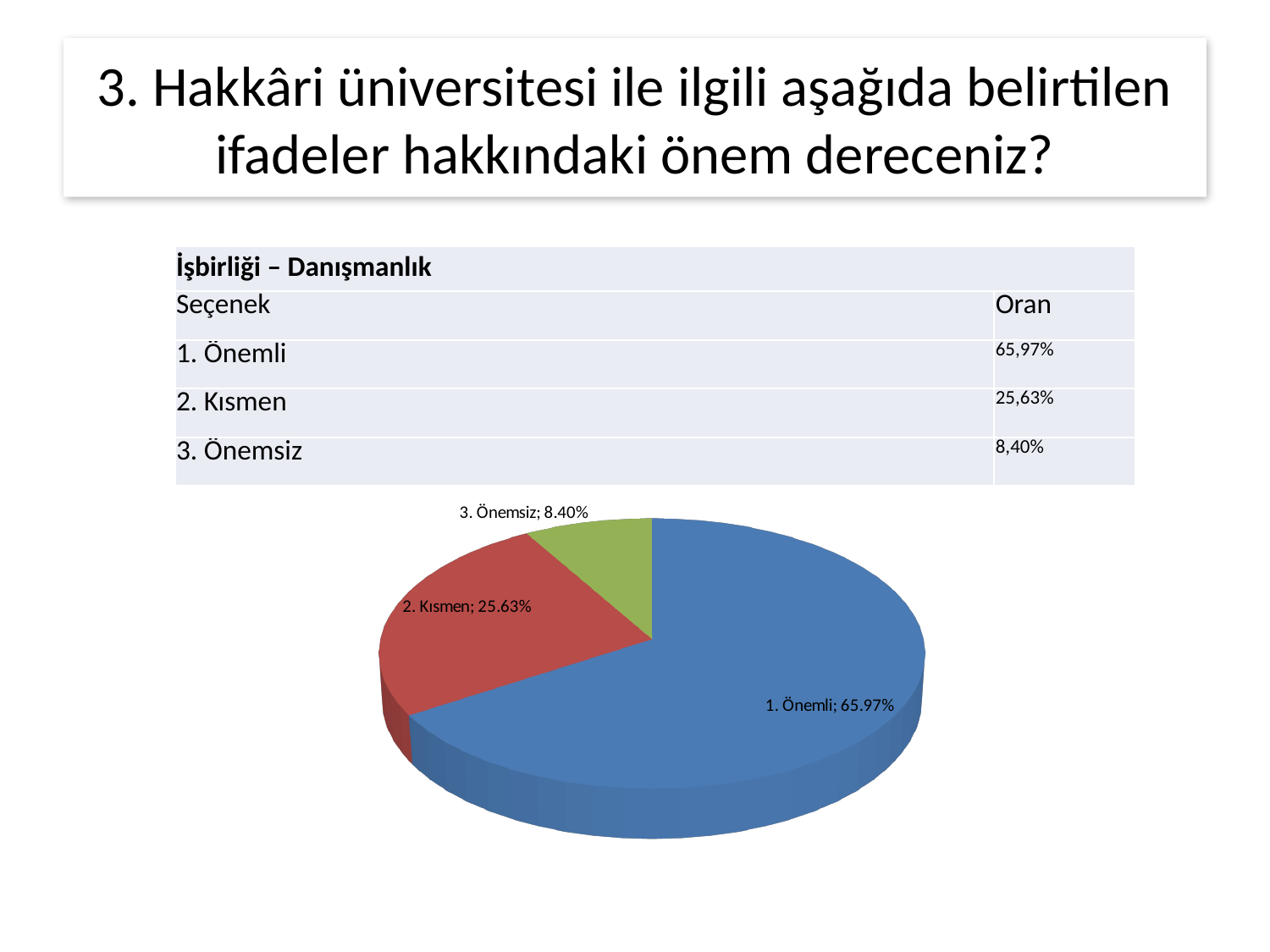
How many slices does the pie chart have? 3 What colour is the slice for "1. Önemli" in the pie chart? blue Which is larger in the pie chart, the share for "2. Kısmen" or the share for "3. Önemsiz"? 2. Kısmen Which category has the smallest slice in the pie chart? 3. Önemsiz What is the share shown for "1. Önemli" in the pie chart? 65.97% Which category has the largest slice in the pie chart? 1. Önemli What is the share shown for "2. Kısmen" in the pie chart? 25.63% What kind of chart is shown on the slide? pie chart What colour is the slice for "3. Önemsiz" in the pie chart? green What is the difference in percentage points between the "1. Önemli" slice and the "2. Kısmen" slice? 40.34 What is the difference in percentage points between the "2. Kısmen" slice and the "3. Önemsiz" slice? 17.23 What is the share shown for "3. Önemsiz" in the pie chart? 8.40%